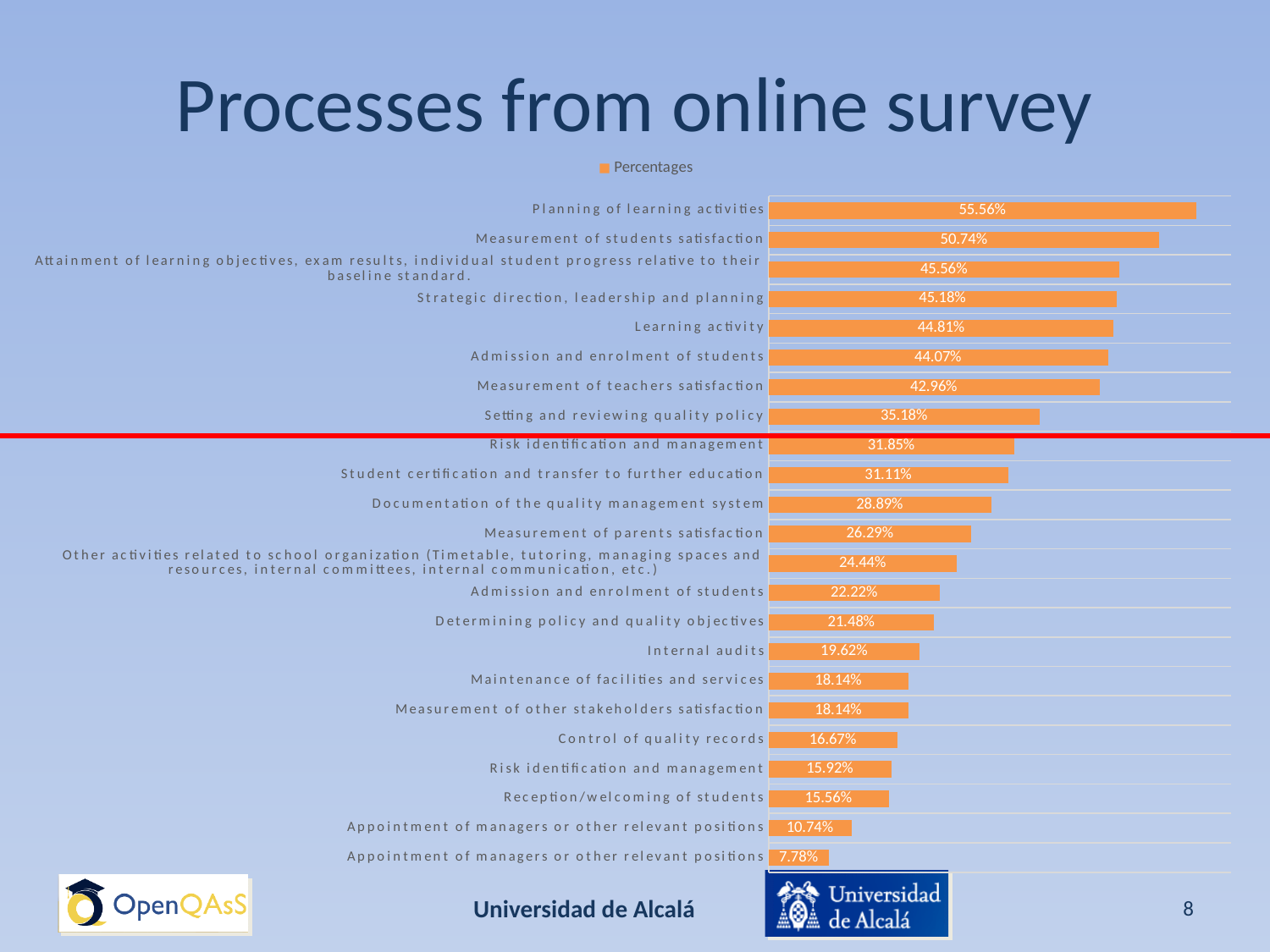
Which is larger, the value for Setting and reviewing quality policy or the value for Documentation of the quality management system? Setting and reviewing quality policy What is the value for Planning of learning activities? 55.56% What is the title of the slide containing the chart? Processes from online survey What is the difference between Planning of learning activities and Measurement of students satisfaction? 4.82% What is the name of the series shown in the legend? Percentages What is the lowest percentage shown in the chart? 7.78% Which process has the highest percentage? Planning of learning activities How many bars are plotted in the chart? 23 What is the value for Internal audits? 19.62% How many series does the legend list? 1 What is the value for Measurement of teachers satisfaction? 42.96% What type of chart is shown on the slide? bar chart